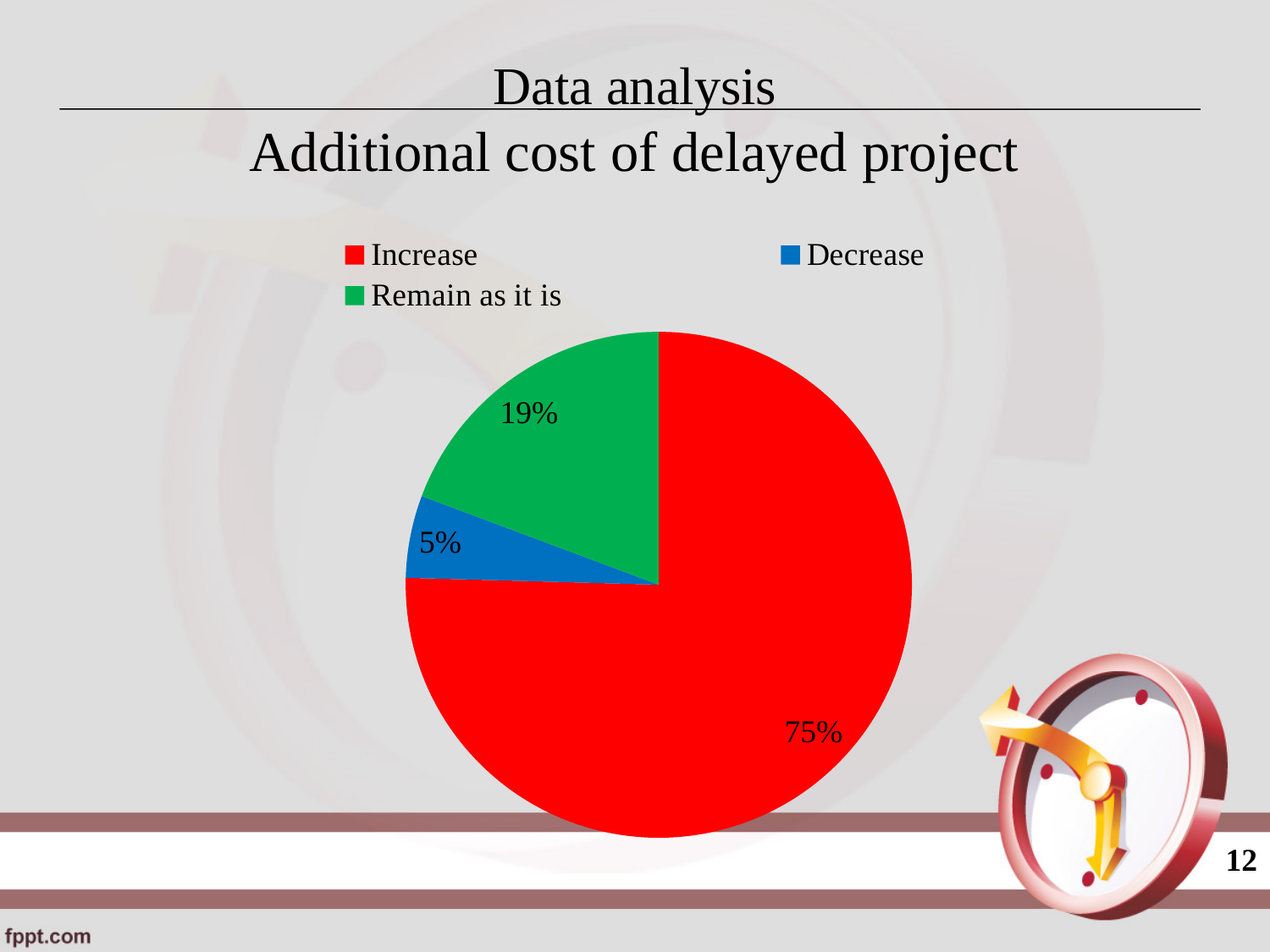
What is the difference in percentage points between the Increase slice and the Remain as it is slice? 56 Which category has the smallest slice of the pie? Decrease What colour is the Increase slice? red What type of chart is shown on the slide? pie chart Which category has the largest slice of the pie? Increase What percentage of the pie is labelled for Remain as it is? 19% What percentage of the pie is labelled for Increase? 75% What is the title of the chart on the slide? Additional cost of delayed project What is the difference in percentage points between the Remain as it is slice and the Decrease slice? 14 Which is larger, the Remain as it is slice or the Decrease slice? Remain as it is What percentage of the pie is labelled for Decrease? 5% How many categories does the legend list? 3